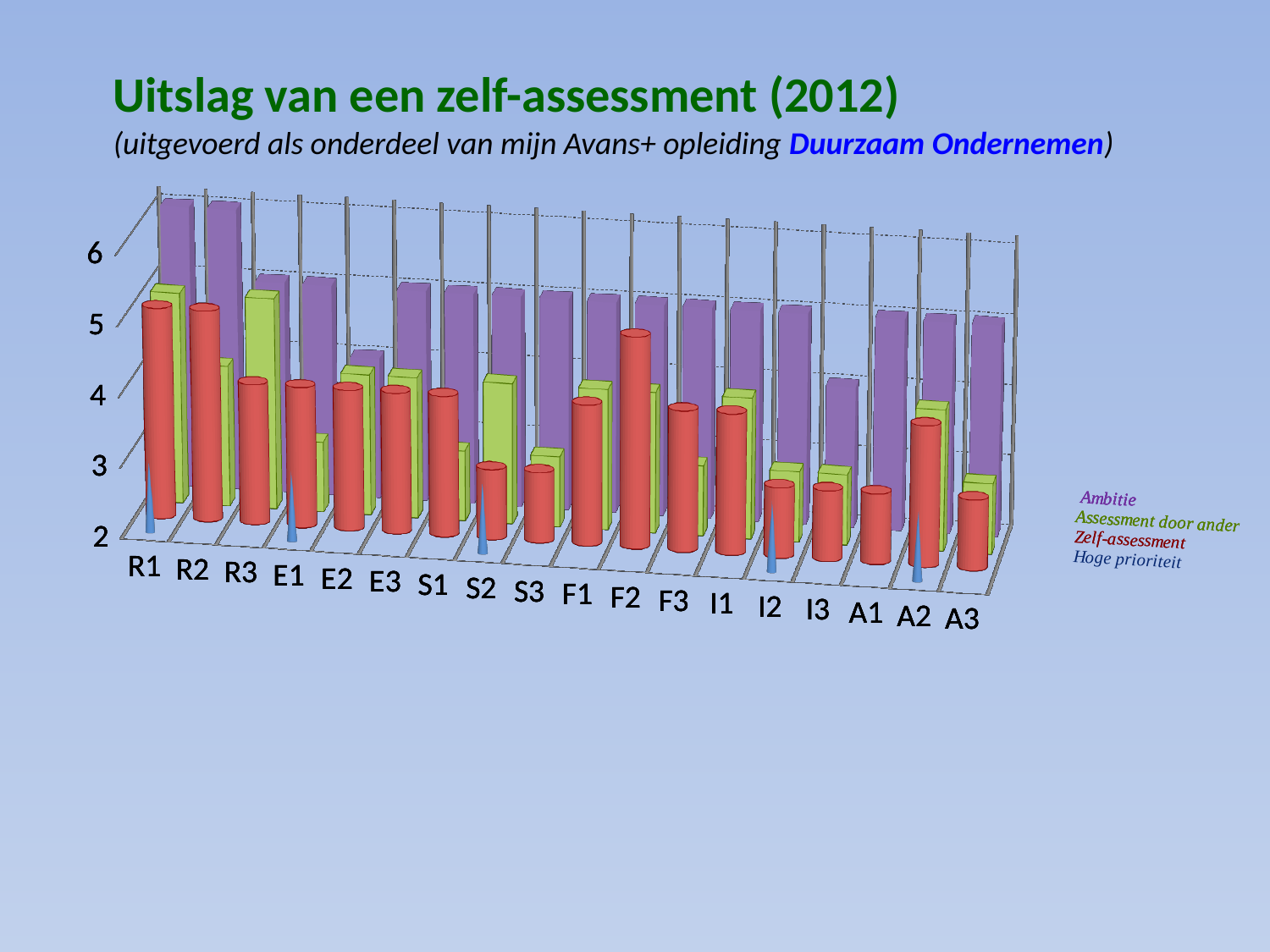
Which is larger, the Assessment door ander value for R1 or for E1? R1 Which is larger, the Zelf-assessment value for R1 or for A3? R1 What kind of chart is shown on the slide? bar chart How many series does the chart's legend list? 4 Which series is shown in purple in the chart? Ambitie Which is larger, the Zelf-assessment value for F2 or for S2? F2 How many categories are shown along the x axis of the chart? 18 Which series is shown in red in the chart? Zelf-assessment